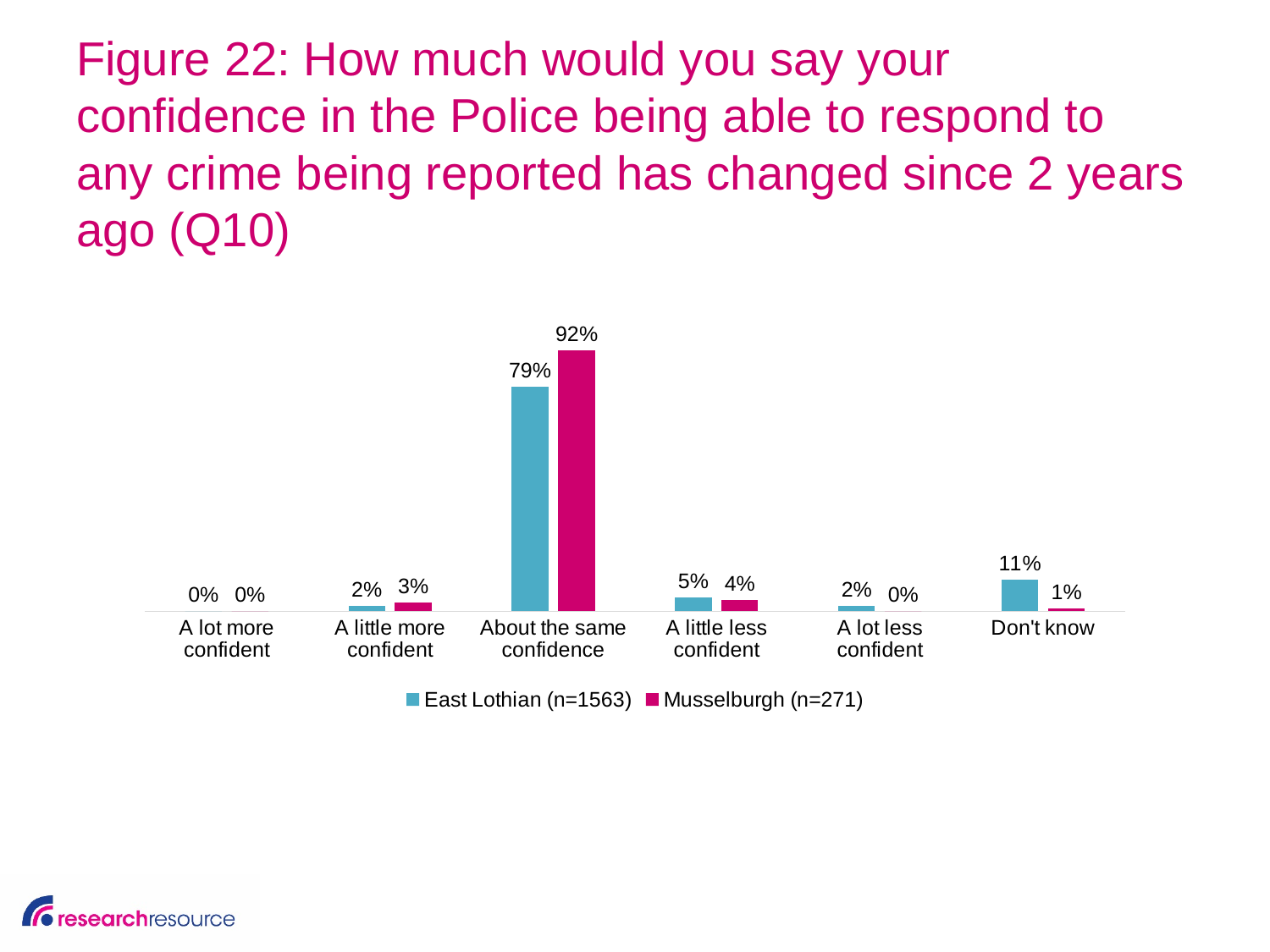
What is the value for East Lothian (n=1563) for 'About the same confidence'? 79% What is the value for East Lothian (n=1563) for 'Don't know'? 11% What is the value for Musselburgh (n=271) for 'A little less confident'? 4% How many series does the legend list? 2 What is the value for Musselburgh (n=271) for 'About the same confidence'? 92% How many categories are shown on the x axis? 6 What is the difference between the East Lothian (n=1563) and Musselburgh (n=271) values for 'Don't know'? 10% Which category has the highest value for Musselburgh (n=271)? About the same confidence Which is larger for 'Don't know': East Lothian (n=1563) or Musselburgh (n=271)? East Lothian (n=1563) Which is larger for 'A little more confident': East Lothian (n=1563) or Musselburgh (n=271)? Musselburgh (n=271) What is the difference between the Musselburgh (n=271) and East Lothian (n=1563) values for 'About the same confidence'? 13% What kind of chart is shown on the slide? Bar chart